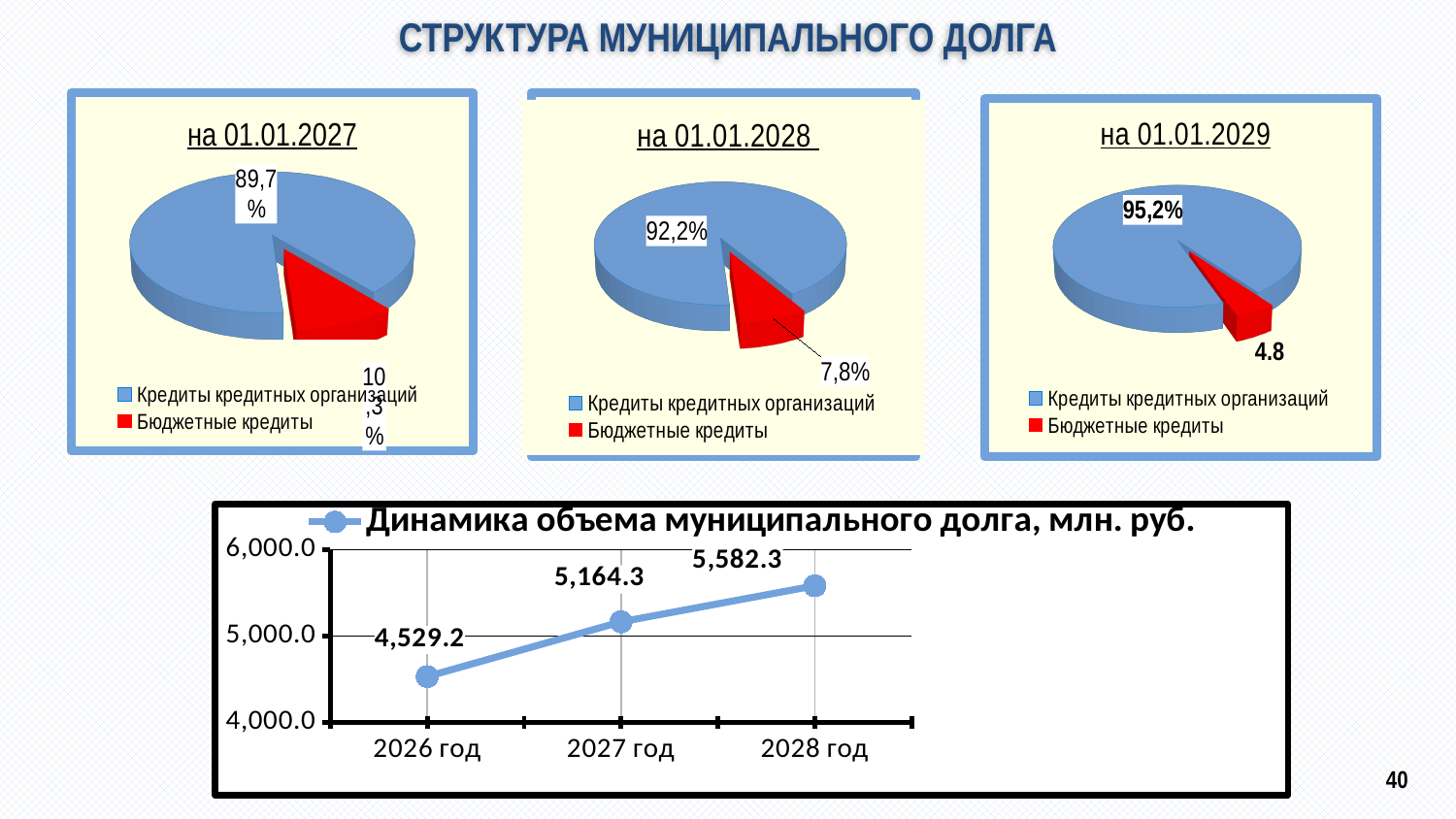
In the pie chart 'на 01.01.2027', what share is labelled for Кредиты кредитных организаций? 89,7% In the pie chart 'на 01.01.2029', what value is labelled on the red slice (Бюджетные кредиты)? 4.8 In the pie chart 'на 01.01.2028', which category has the larger share? Кредиты кредитных организаций In the pie chart 'на 01.01.2029', what value is labelled for Кредиты кредитных организаций? 95,2% In the line chart 'Динамика объема муниципального долга, млн. руб.', what is the difference between the values for 2028 год and 2026 год? 1,053.1 In the line chart 'Динамика объема муниципального долга, млн. руб.', do the values rise or fall from 2026 год to 2028 год? rise How many entries does the legend of the pie chart 'на 01.01.2027' list? 2 In the line chart 'Динамика объема муниципального долга, млн. руб.', what is the value for 2026 год? 4,529.2 In the line chart 'Динамика объема муниципального долга, млн. руб.', which year has the lowest value? 2026 год In the pie chart 'на 01.01.2028', what share is labelled for Бюджетные кредиты? 7,8% In the line chart 'Динамика объема муниципального долга, млн. руб.', what is the value for 2028 год? 5,582.3 In the pie chart 'на 01.01.2027', what share is labelled for Бюджетные кредиты? 10,3%